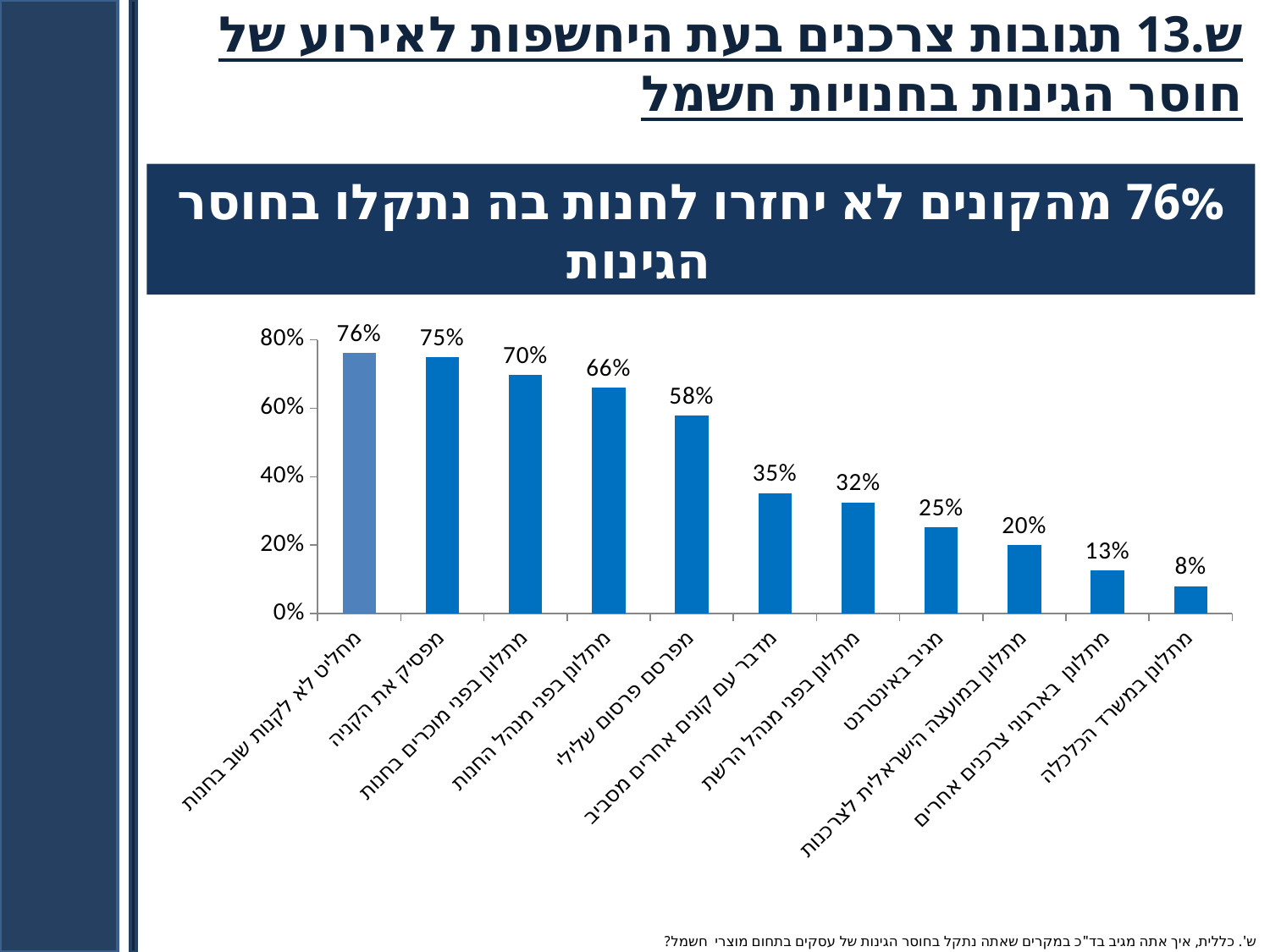
How many categories are shown in the chart? 11 Which category has the lowest value in the chart? מתלונן במשרד הכלכלה Which bar is shown in a lighter shade of blue than the others? מחליט לא לקנות שוב בחנות What percentage is shown for "מגיב באינטרנט"? 25% What value is shown for "מפרסם פרסום שלילי"? 58% Is the value for "מתלונן בפני מוכרים בחנות" greater or less than 60%? greater Which is larger: the value for "מדבר עם קונים אחרים מסביב" or the value for "מתלונן במועצה הישראלית לצרכנות"? מדבר עם קונים אחרים מסביב What type of chart is shown on the slide? bar chart Do the values rise or fall from left to right along the x axis? fall What is the difference between the values for "מתלונן בפני מנהל החנות" and "מתלונן בפני מנהל הרשת"? 34% What percentage is shown for "מחליט לא לקנות שוב בחנות"? 76% Which category has the highest value in the chart? מחליט לא לקנות שוב בחנות